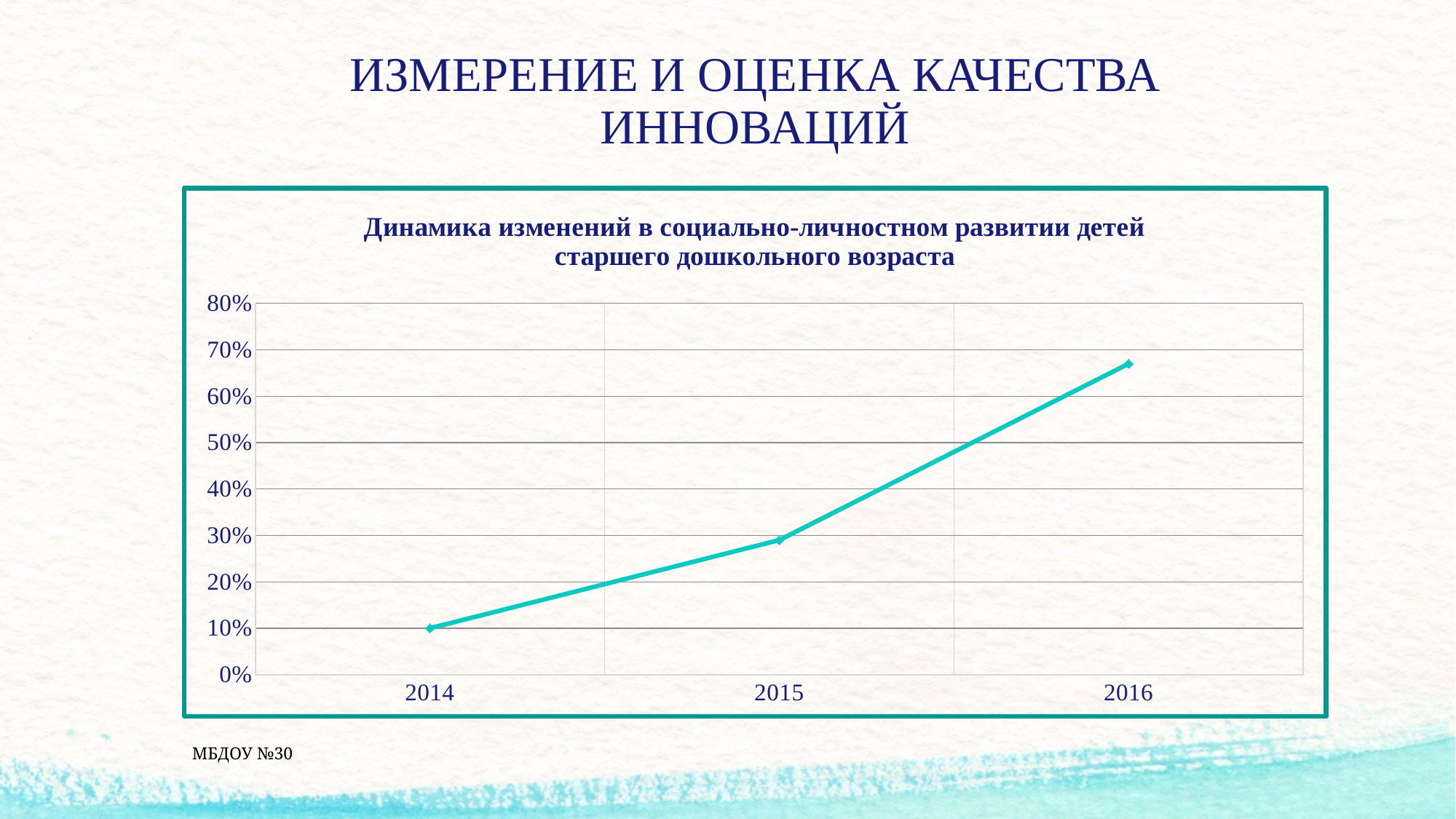
What is the title of the chart? Динамика изменений в социально-личностном развитии детей старшего дошкольного возраста Which year has the highest value in the chart? 2016 What is the value for 2014? 10% Which year has the lowest value in the chart? 2014 Which is larger, the value for 2015 or the value for 2016? 2016 How many years are plotted on the x axis of the chart? 3 Is the value for 2015 greater or less than 20%? greater What kind of chart is shown on the slide? line chart Is the value for 2016 greater or less than 70%? less Is the value for 2016 greater or less than 60%? greater Do the values rise or fall from 2014 to 2016? rise